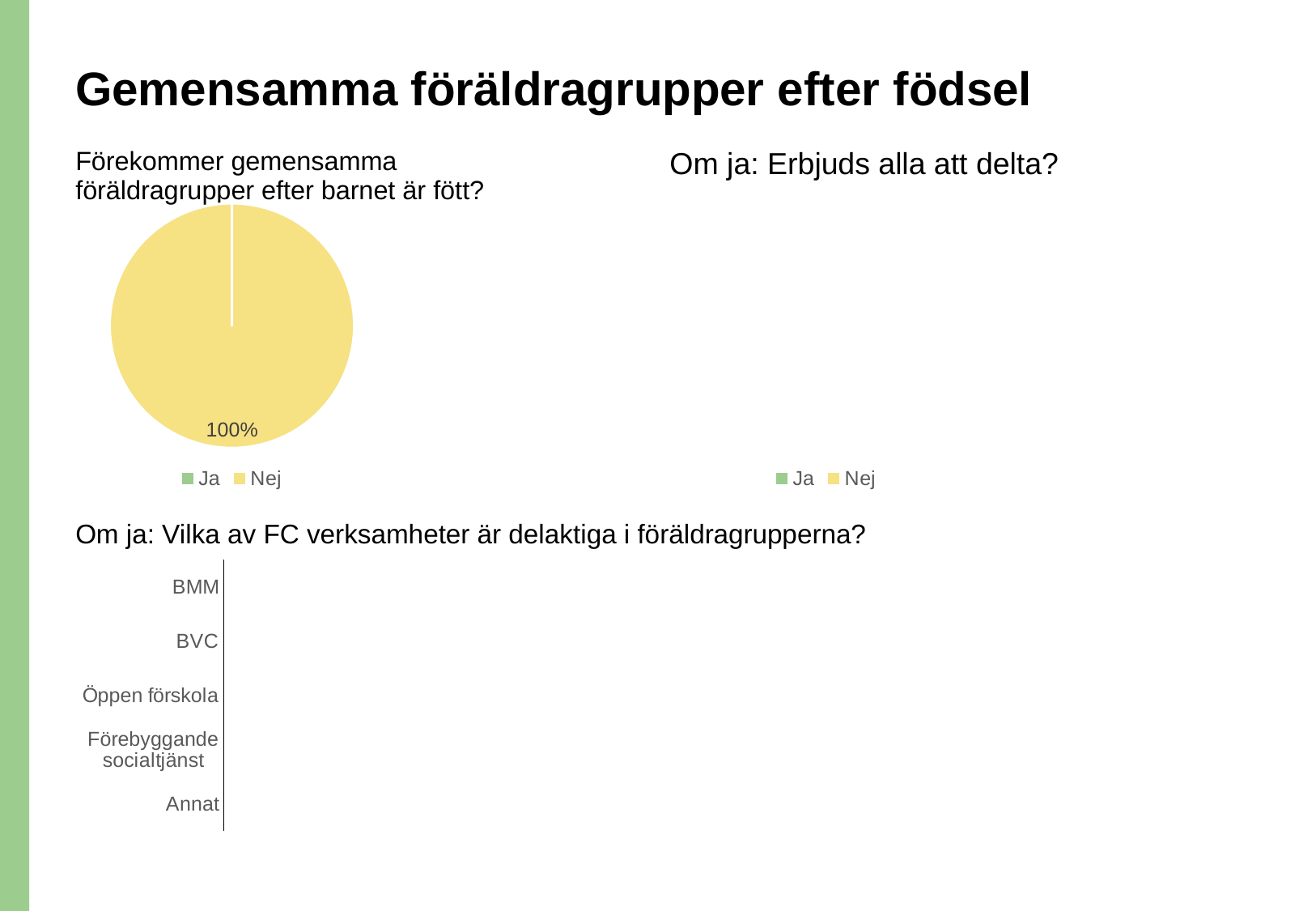
In the chart titled "Förekommer gemensamma föräldragrupper efter barnet är fött?", what kind of chart is shown? Pie chart In the chart titled "Förekommer gemensamma föräldragrupper efter barnet är fött?", what colour represents Nej? Yellow In the chart titled "Om ja: Erbjuds alla att delta?", what are the legend entries? Ja, Nej In the chart titled "Förekommer gemensamma föräldragrupper efter barnet är fött?", what share of the pie is Nej? 100% In the chart titled "Förekommer gemensamma föräldragrupper efter barnet är fött?", which category makes up the whole pie? Nej In the chart titled "Om ja: Vilka av FC verksamheter är delaktiga i föräldragrupperna?", how many categories are listed on the axis? 5 In the chart titled "Om ja: Erbjuds alla att delta?", how many entries does the legend list? 2 In the chart titled "Förekommer gemensamma föräldragrupper efter barnet är fött?", how many entries does the legend list? 2